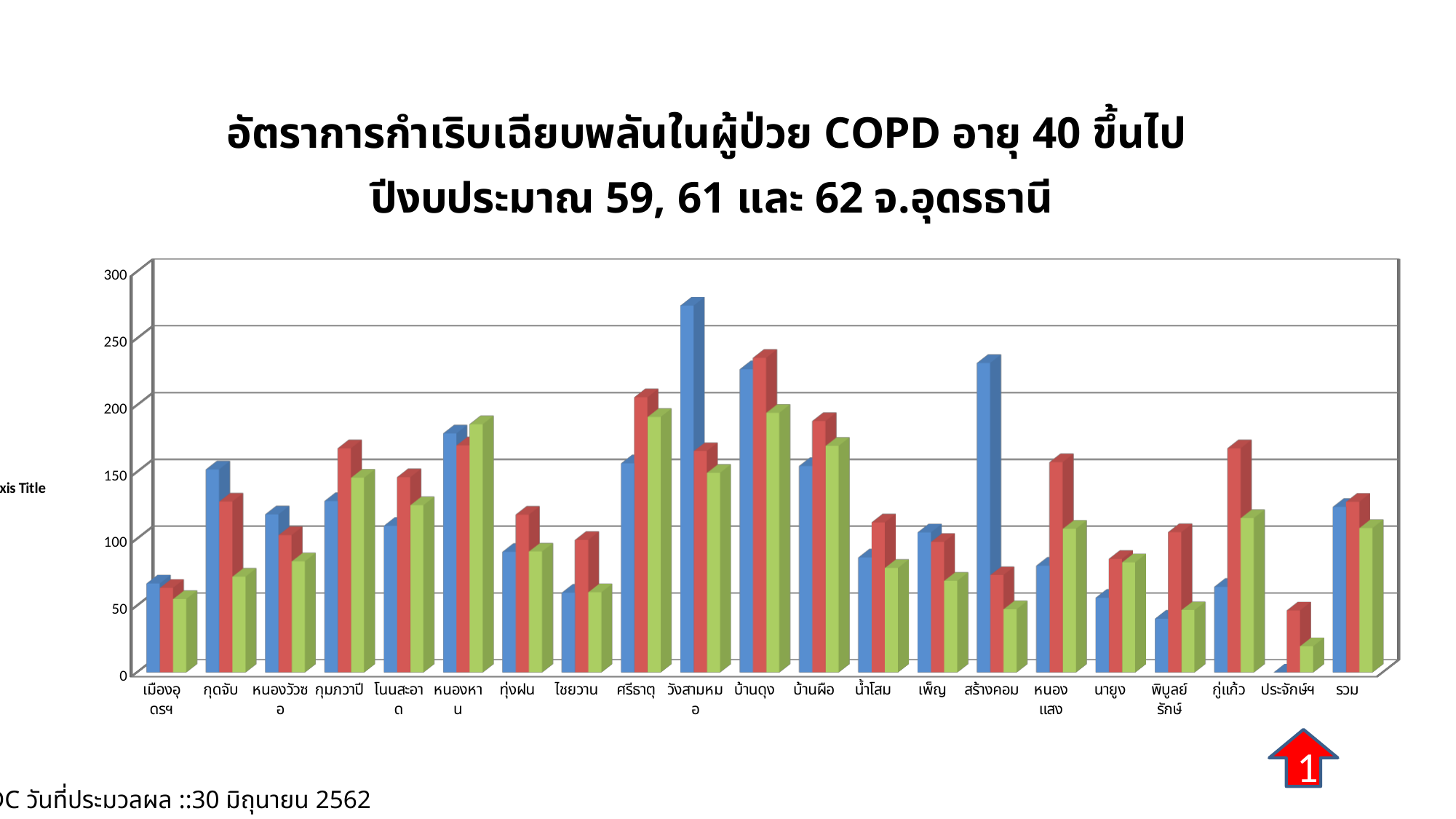
Which is taller: the blue bar for วังสามหมอ or the blue bar for บ้านดุง? วังสามหมอ How many categories are shown along the x axis of the chart? 21 What kind of chart is shown on the slide? bar chart Is the blue bar for วังสามหมอ greater or less than 250? greater Which category has the tallest red bar in the chart? บ้านดุง Is the blue bar for ไชยวาน greater or less than 100? less Which category has the shortest green bar in the chart? ประจักษ์ฯ What is the highest value shown on the vertical axis of the chart? 300 Is the blue bar for สร้างคอม greater or less than 200? greater How many bars (series) are plotted for each category in the chart? 3 Which category has the shortest blue bar in the chart? ประจักษ์ฯ Which category has the tallest blue bar in the chart? วังสามหมอ